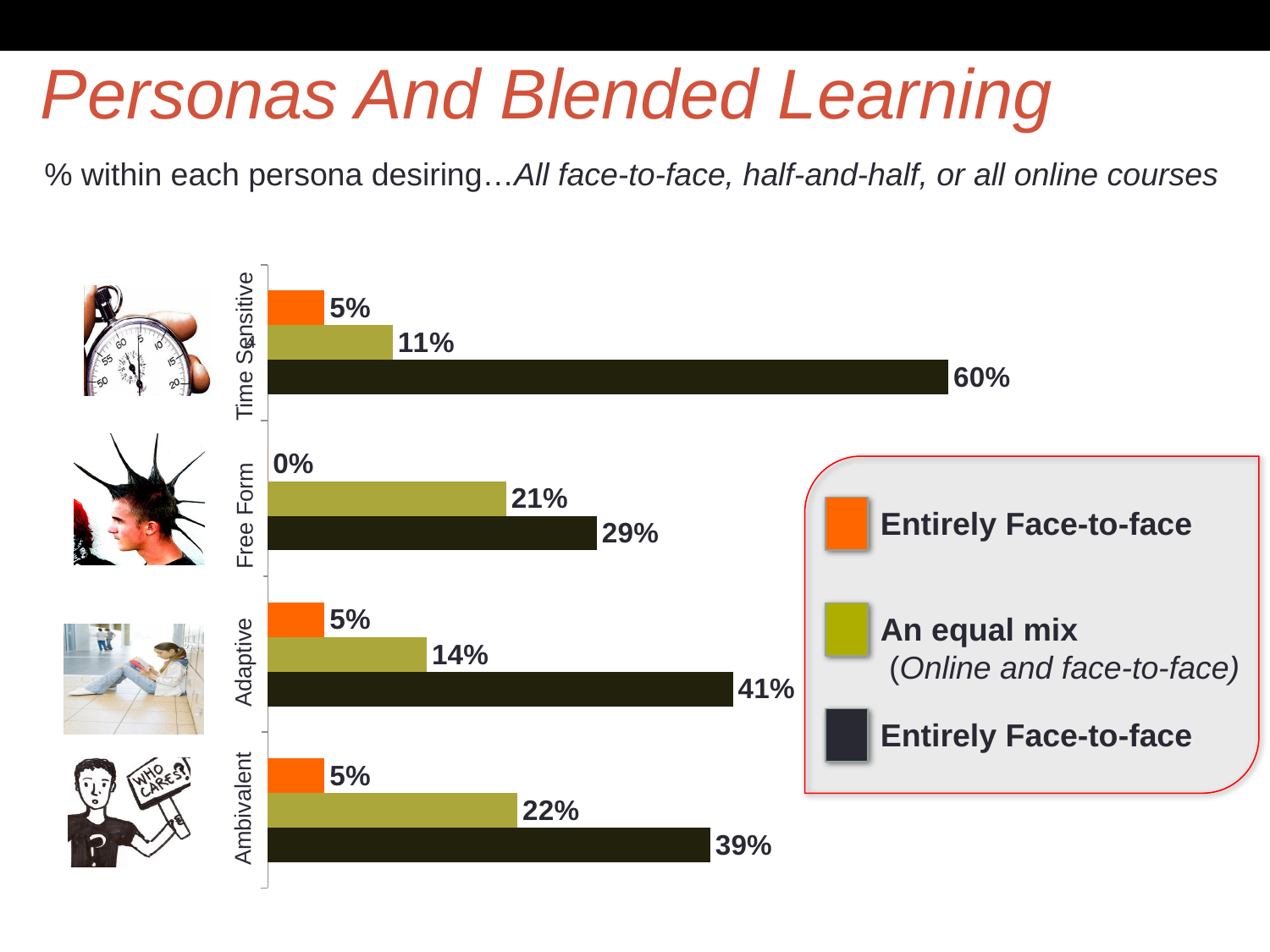
What percentage of the Free Form persona desires entirely face-to-face courses (orange bar)? 0% What percentage of the Time Sensitive persona desires an equal mix of online and face-to-face courses? 11% Which persona has the lowest value for 'An equal mix'? Time Sensitive What type of chart is shown on the slide? bar chart How many personas (categories) are shown on the chart? 4 What is the difference between the dark bar values for Adaptive and Ambivalent? 2% Which persona has the highest value for the dark (bottom) bar? Time Sensitive What is the value of the dark (bottom) bar for the Time Sensitive persona? 60% How many series does the legend list? 3 Which series does the orange colour represent in the legend? Entirely Face-to-face What is the 'An equal mix' value for the Ambivalent persona? 22% Which persona has a larger 'An equal mix' value, Free Form or Adaptive? Free Form